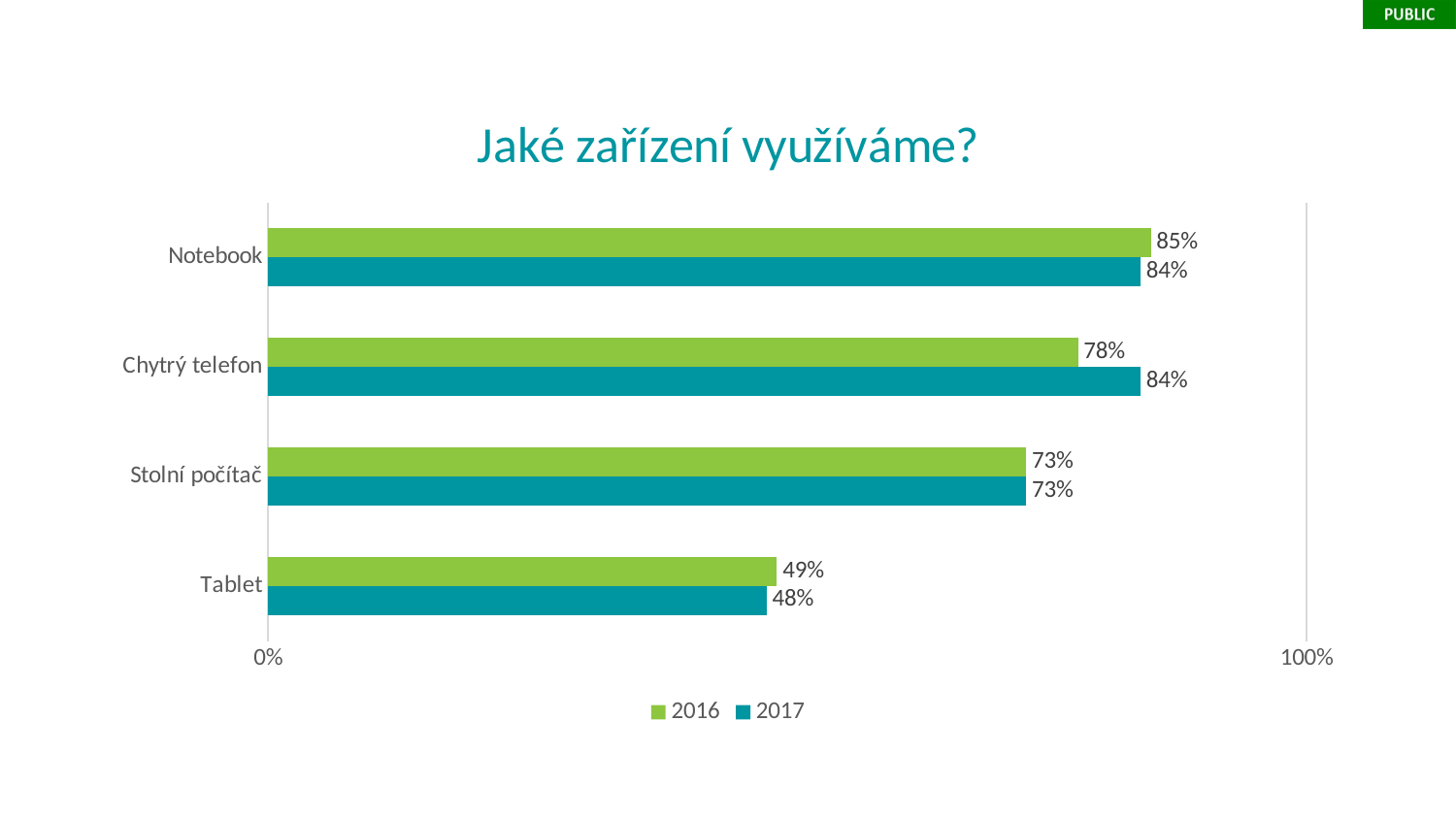
What is the 2017 value for Tablet? 48% What is the title of the chart? Jaké zařízení využíváme? What is the 2016 value for Stolní počítač? 73% What is the 2017 value for Chytrý telefon? 84% Which is larger for Chytrý telefon, the 2016 value or the 2017 value? 2017 What is the difference between the 2017 and 2016 values for Chytrý telefon? 6% What kind of chart is shown on the slide? Bar chart How many categories are shown on the chart? 4 What is the 2016 value for Notebook? 85% How many series does the legend list? 2 Which category has the lowest 2016 value? Tablet Which category has the highest 2016 value? Notebook